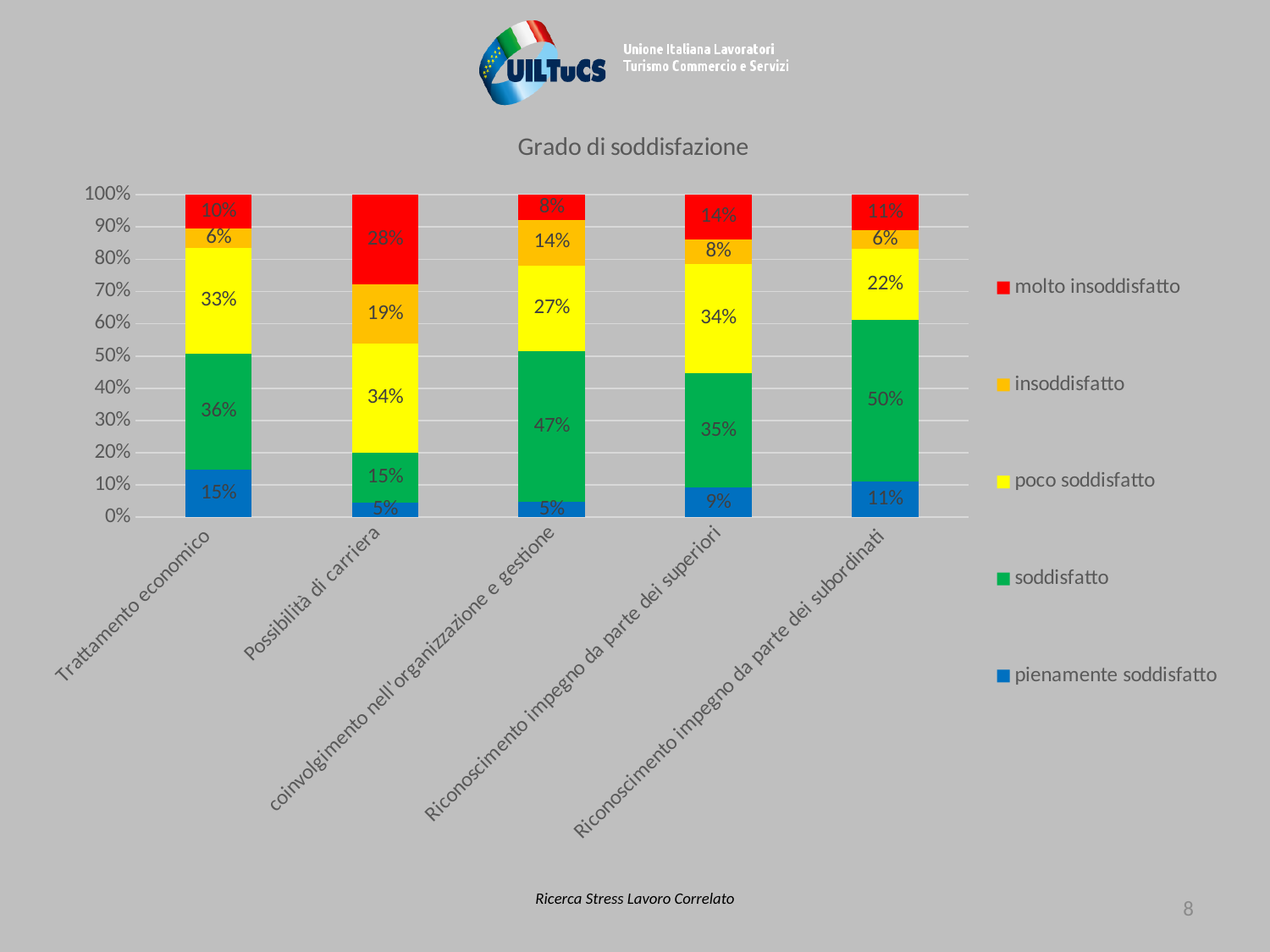
What is the 'pienamente soddisfatto' value for 'Riconoscimento impegno da parte dei subordinati'? 11% What is the 'soddisfatto' value for 'Trattamento economico'? 36% What kind of chart is shown on the slide? stacked bar chart What is the title of the chart? Grado di soddisfazione How many categories are shown on the x axis? 5 What is the difference between the 'poco soddisfatto' values for 'Possibilità di carriera' and 'Riconoscimento impegno da parte dei subordinati'? 12% Which colour represents the 'poco soddisfatto' series? yellow Which category has the highest 'soddisfatto' value? Riconoscimento impegno da parte dei subordinati How many series does the legend list? 5 Which category has the lowest 'molto insoddisfatto' value? coinvolgimento nell'organizzazione e gestione What is the 'molto insoddisfatto' value for 'Possibilità di carriera'? 28% Which is larger: the 'insoddisfatto' value for 'coinvolgimento nell'organizzazione e gestione' or for 'Riconoscimento impegno da parte dei superiori'? coinvolgimento nell'organizzazione e gestione